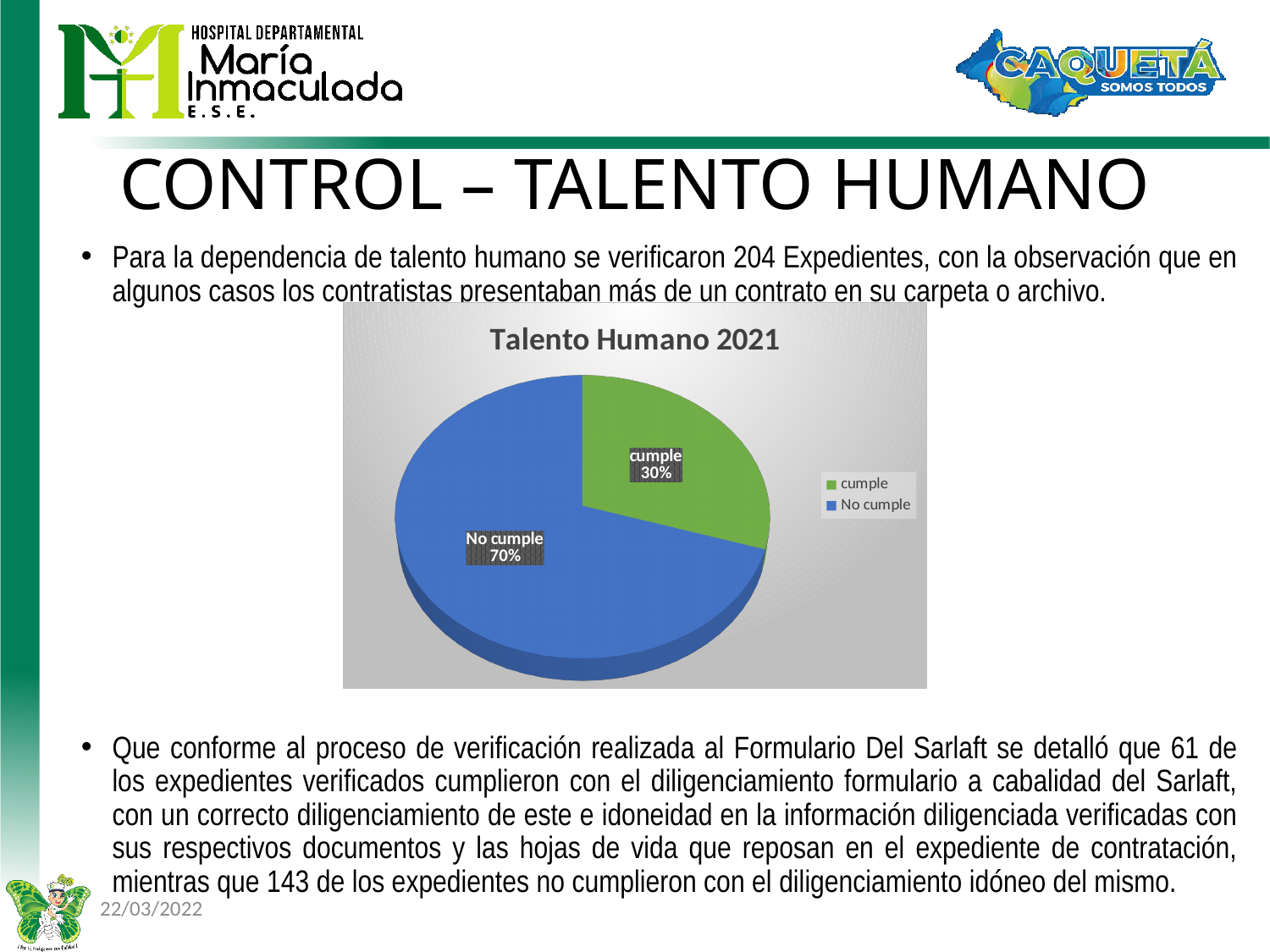
What kind of chart is shown on the slide? pie chart Which slice is the largest in the pie chart? No cumple What is the title of the chart? Talento Humano 2021 Which slice is the smallest in the pie chart? cumple What percentage of the pie does the 'cumple' slice represent? 30% How many entries does the legend list? 2 Which is larger, the 'cumple' slice or the 'No cumple' slice? No cumple Is the share for 'cumple' greater or less than 50%? less How many slices does the pie chart have? 2 What colour is the 'No cumple' slice? blue What is the difference in percentage points between the 'No cumple' and 'cumple' slices? 40 What percentage of the pie does the 'No cumple' slice represent? 70%